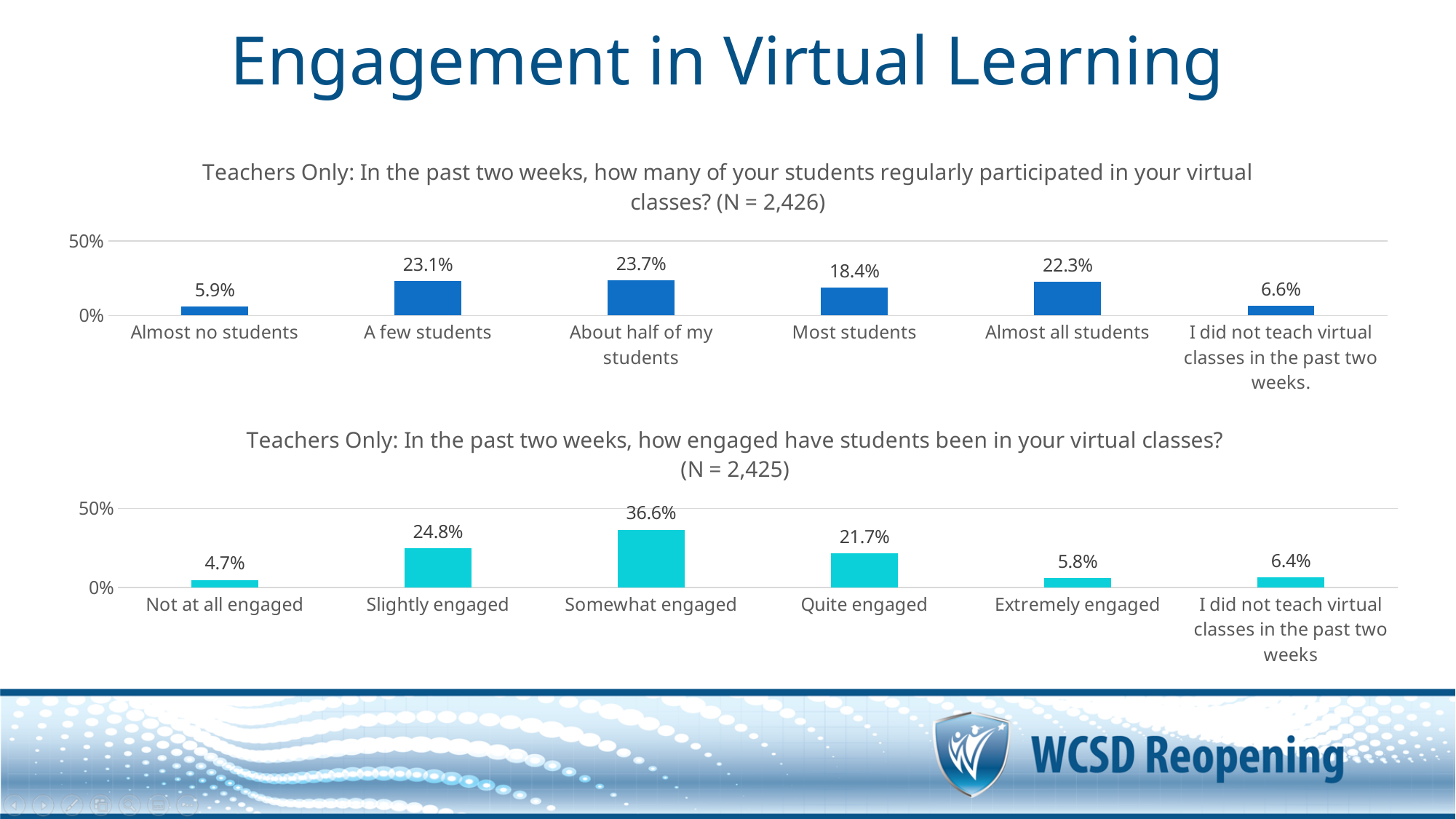
In the bottom chart (how engaged students have been), which category has the lowest value? Not at all engaged In the bottom chart (how engaged students have been), what is the difference between "Somewhat engaged" and "Slightly engaged"? 11.8 percentage points In the bottom chart (how engaged students have been), which category has the highest value? Somewhat engaged In the bottom chart (how engaged students have been), which is larger: "Extremely engaged" or "I did not teach virtual classes in the past two weeks"? I did not teach virtual classes in the past two weeks In the top chart (how many students regularly participated), which category has the lowest value? Almost no students In the top chart (how many students regularly participated), what percentage of teachers answered "Almost all students"? 22.3% In the top chart (how many students regularly participated), what percentage of teachers answered "A few students"? 23.1% In the top chart (how many students regularly participated), what is the difference between "About half of my students" and "Most students"? 5.3 percentage points How many categories are shown in the bottom chart (how engaged students have been)? 6 What type of chart is the top chart (how many students regularly participated)? Bar chart In the bottom chart (how engaged students have been), what percentage of teachers answered "Quite engaged"? 21.7% In the top chart (how many students regularly participated), which category has the highest value? About half of my students